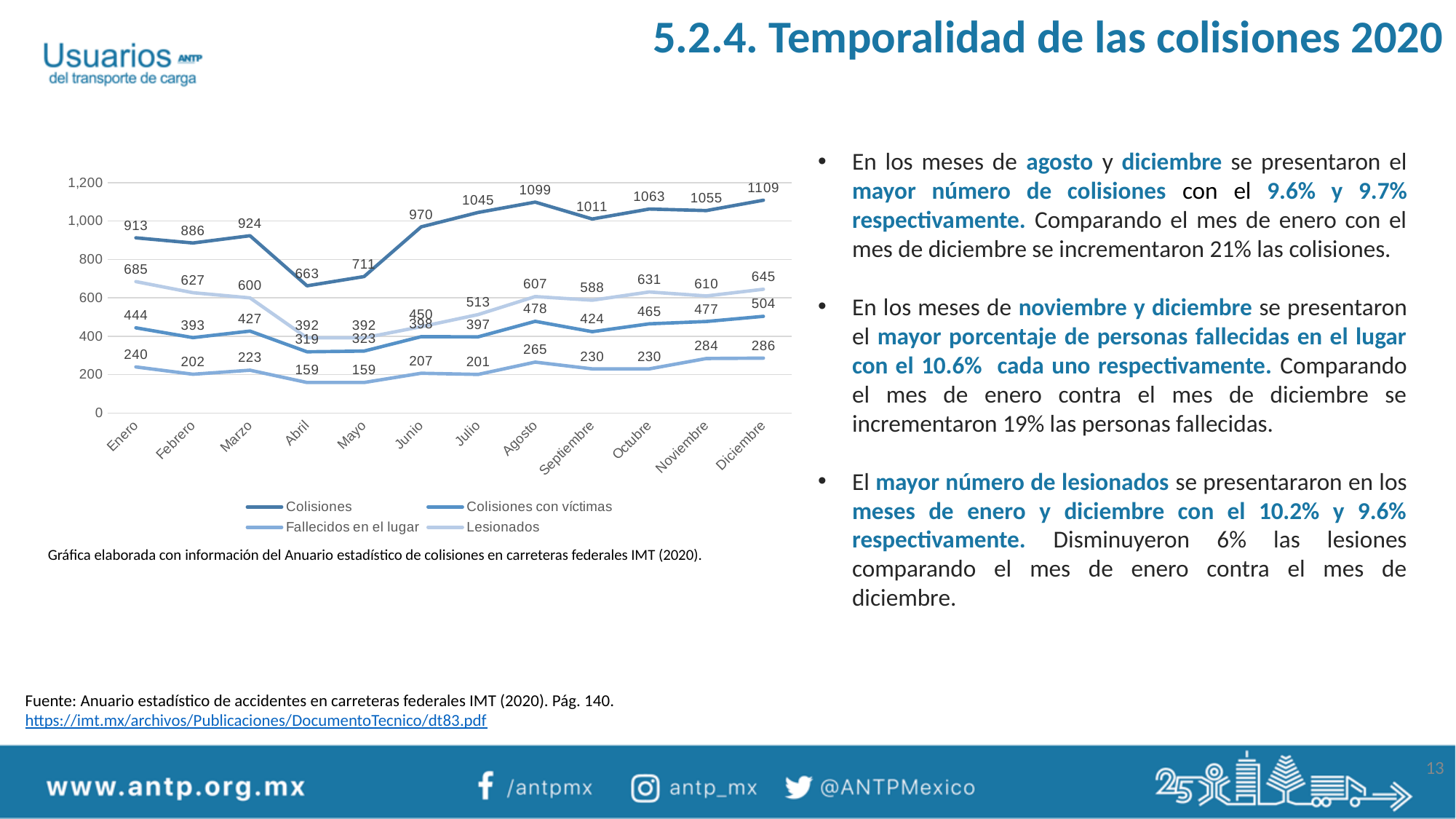
In which month is the Colisiones series lowest? Abril Which is larger, Lesionados in Agosto or Lesionados in Octubre? Lesionados in Octubre Does the Colisiones series rise or fall from Marzo to Abril? fall What is the value of Lesionados for Enero? 685 How many months are plotted along the x axis of the chart? 12 How many series does the chart legend list? 4 What is the value of Colisiones for Diciembre? 1109 What kind of chart is shown on the slide? line chart What is the difference between Colisiones in Diciembre and Colisiones in Enero? 196 What is the value of Fallecidos en el lugar for Agosto? 265 In which month is the Colisiones con víctimas series highest? Diciembre Which series is drawn with the darkest blue line in the chart? Colisiones